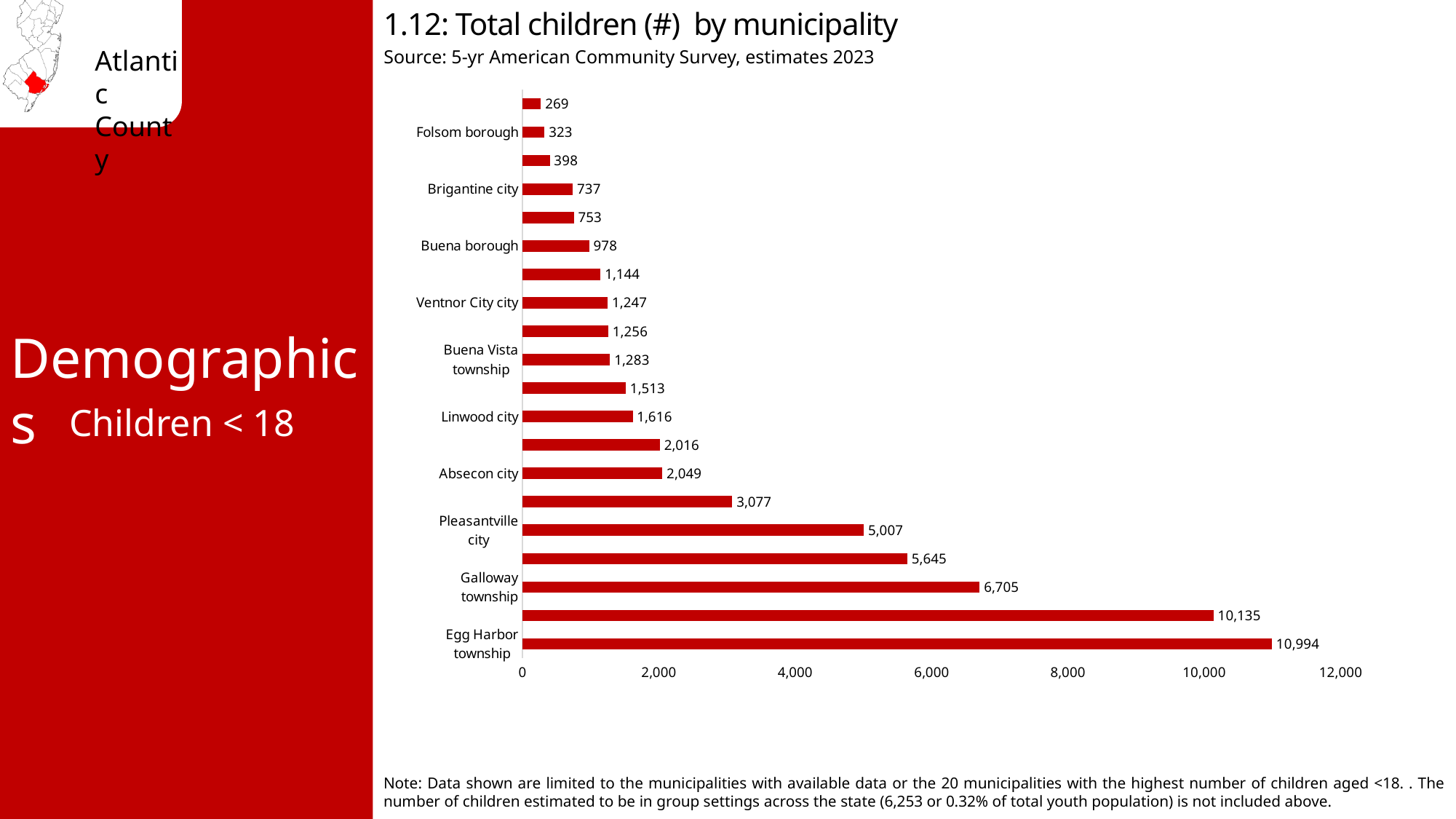
What is the difference between the values for Pleasantville city and Absecon city? 2,958 What is the value for Pleasantville city? 5,007 What is the smallest value shown on the chart? 269 Which municipality has the highest number of children? Egg Harbor township What is the value for Folsom borough? 323 What is the value for Galloway township? 6,705 What is the value for Egg Harbor township? 10,994 What kind of chart is shown on the slide? bar chart How many bars are plotted on the chart? 20 Is the value for Galloway township greater or less than 6,000? greater What is the difference between the values for Egg Harbor township and Galloway township? 4,289 Which has a larger value, Brigantine city or Buena borough? Buena borough